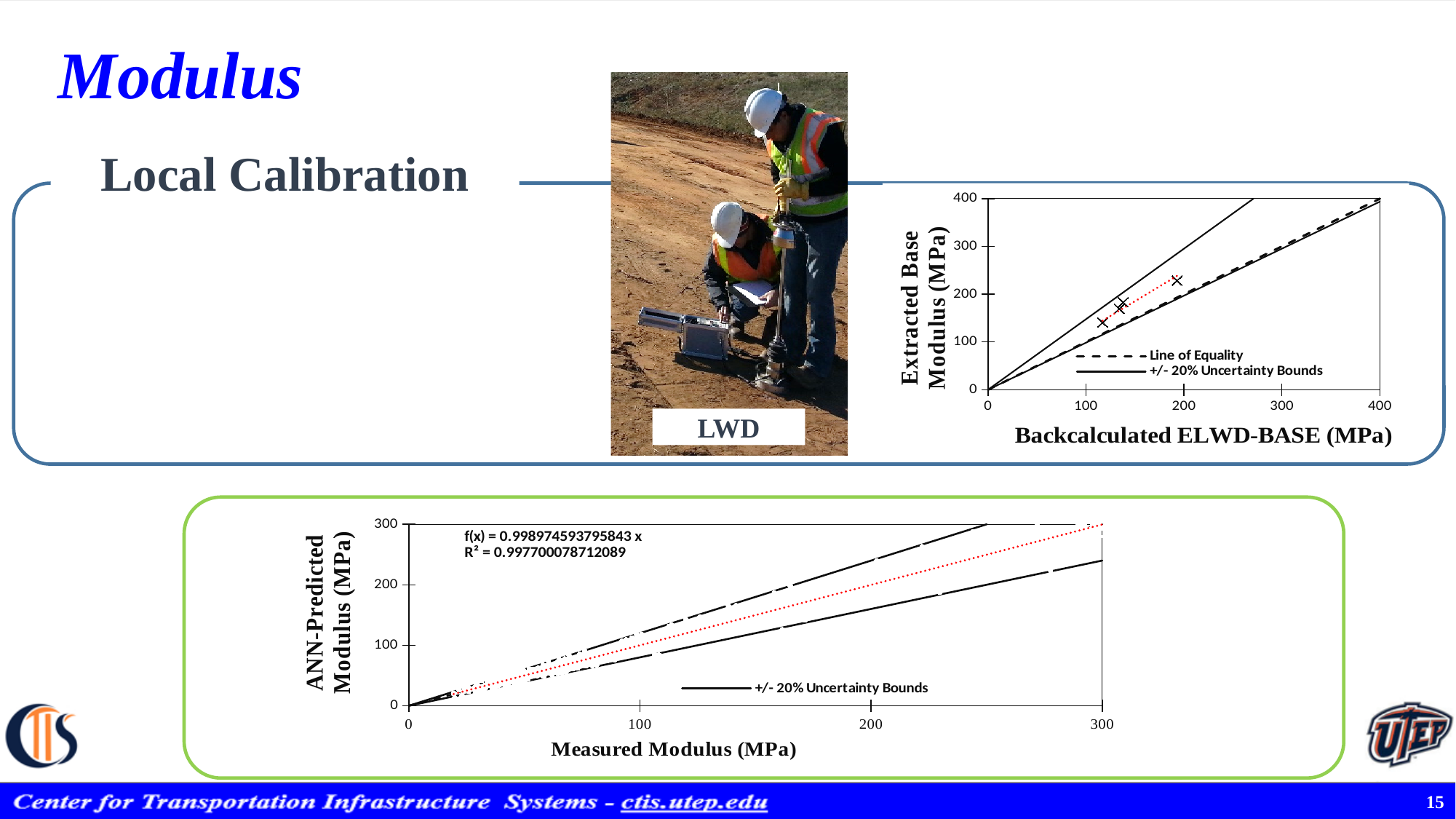
In the bottom chart, what is the label of the x-axis? Measured Modulus (MPa) In the top-right chart, what is the label of the y-axis? Extracted Base Modulus (MPa) In the bottom chart, what is the R² value printed on the chart? 0.997700078712089 In the bottom chart, do the plotted values rise or fall as Measured Modulus increases? rise In the bottom chart, what is the maximum value shown on the y-axis? 300 In the top-right chart, how many entries does the legend list? 2 In the top-right chart, is the Backcalculated ELWD-BASE value of the lowest plotted point greater or less than 200? less In the top-right chart, how many data points (x markers) are plotted? 4 In the bottom chart, what is the fitted equation f(x) printed on the chart? f(x) = 0.998974593795843 x In the top-right chart, what is the maximum value shown on the x-axis? 400 In the top-right chart, is the Extracted Base Modulus of the highest plotted point greater or less than 200? greater What kind of chart is the top-right chart with the x-axis 'Backcalculated ELWD-BASE (MPa)'? scatter chart